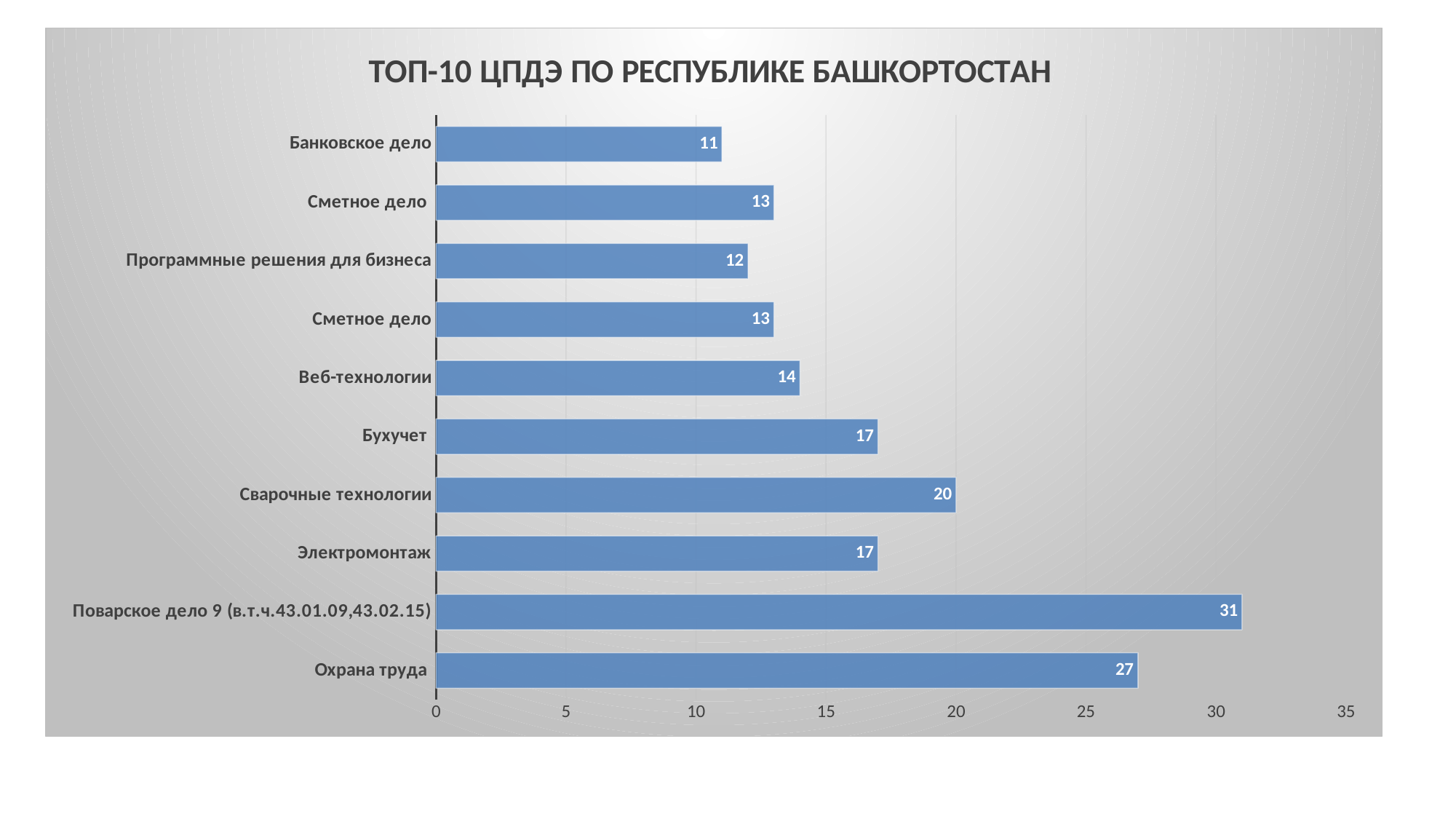
What is the difference between the values for Сварочные технологии and Электромонтаж? 3 What is the value for Сварочные технологии? 20 Which category has the highest value? Поварское дело 9 (в.т.ч.43.01.09,43.02.15) How many bars are shown in the chart? 10 What is the value for Веб-технологии? 14 Is the value for Охрана труда greater or less than 25? greater What is the value for Охрана труда? 27 What is the value for Банковское дело? 11 What is the difference between the values for Поварское дело 9 (в.т.ч.43.01.09,43.02.15) and Охрана труда? 4 Which category has the lowest value? Банковское дело Which is larger, the value for Бухучет or the value for Программные решения для бизнеса? Бухучет What type of chart is shown on the slide? Bar chart